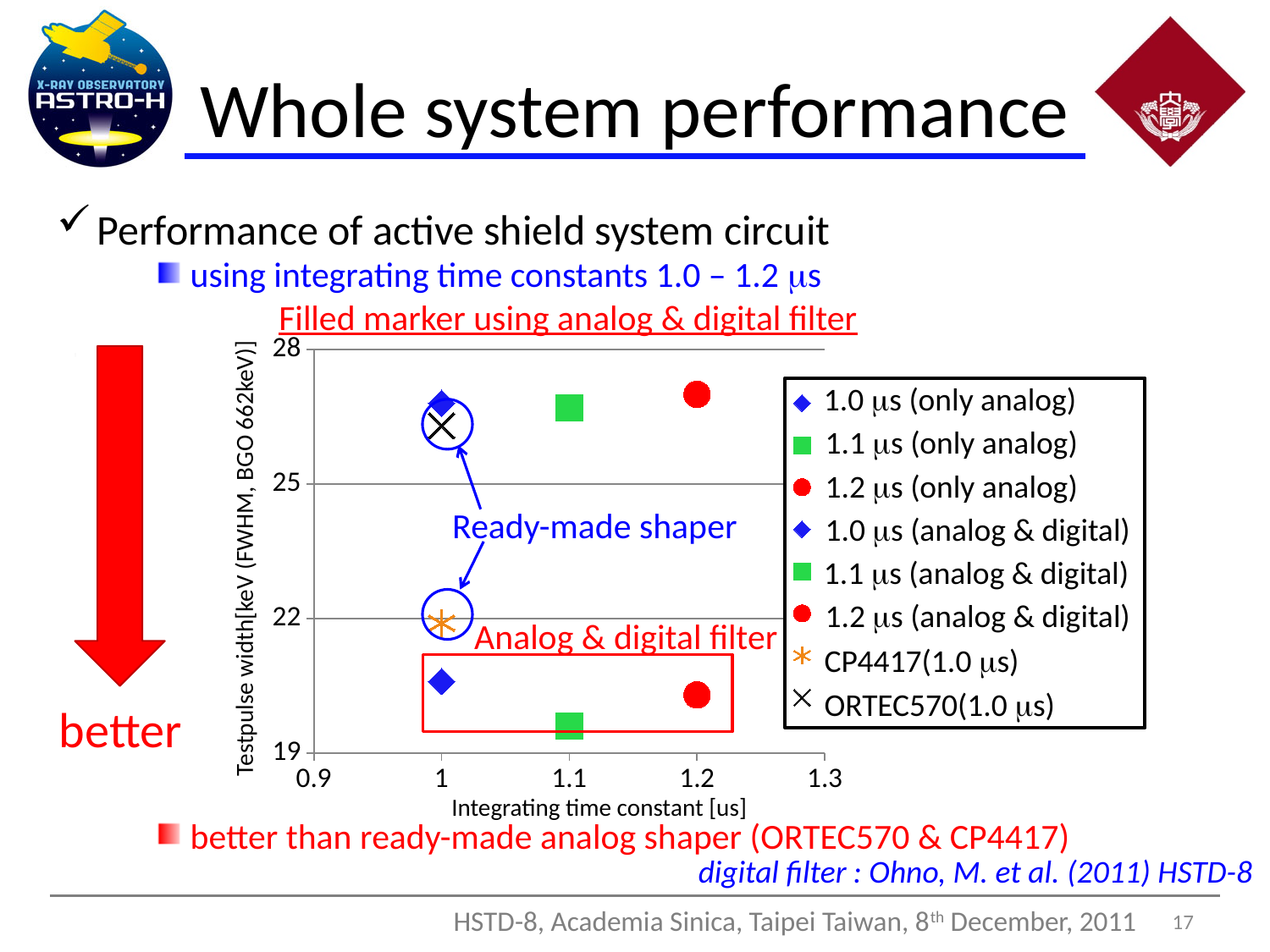
How many series does the chart legend list? 8 Which has the larger test pulse width: 1.0 μs (only analog) or 1.0 μs (analog & digital)? 1.0 μs (only analog) Is the value for 1.0 μs (only analog) greater or less than 25? greater What kind of chart is shown on the slide? scatter chart Is the value for ORTEC570(1.0 μs) greater or less than 25? greater How many data points are plotted on the chart? 8 Is the value for 1.2 μs (analog & digital) greater or less than 22? less Which series has the lowest test pulse width on the chart? 1.1 μs (analog & digital) What is the title of the x axis of the chart? Integrating time constant [us] What colour is the marker for the 1.2 μs series in the chart legend? red